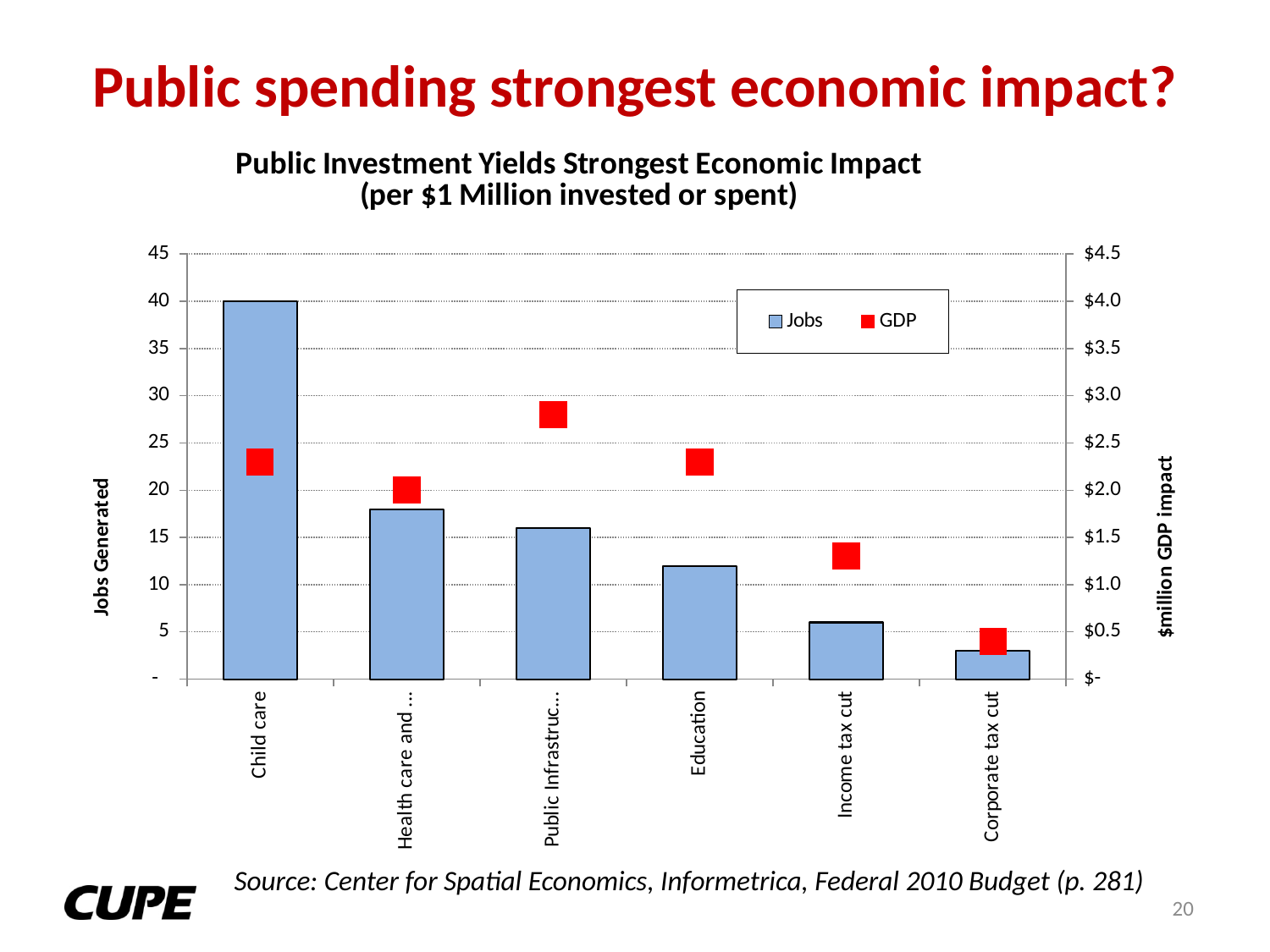
How many series does the chart legend list? 2 Which generates more jobs, Education or Income tax cut? Education Which category has the lowest number of jobs generated? Corporate tax cut What kind of chart is shown on the slide? bar chart Is the Jobs value for Income tax cut greater or less than 5? greater Which category has the highest number of jobs generated? Child care How many jobs are generated per $1 million for Child care? 40 Do the Jobs bars rise or fall moving from left to right along the x axis? fall How many categories are shown along the x axis of the chart? 6 Is the Jobs value for Education greater or less than 15? less Is the GDP impact for Corporate tax cut greater or less than $1.0 million? less What are the two entries listed in the chart legend? Jobs and GDP